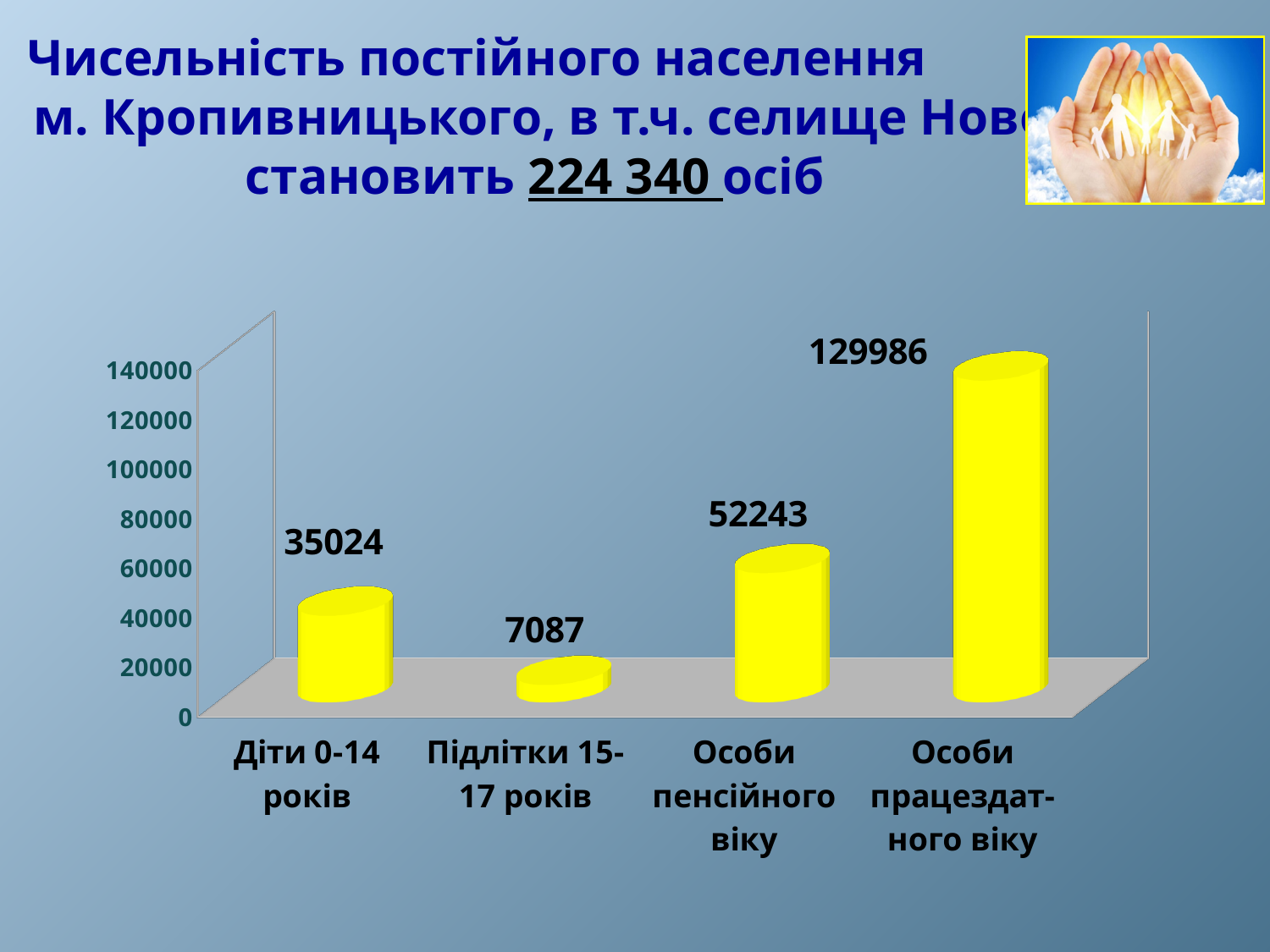
Which category has the highest value? Особи працездатного віку What is the value for Особи пенсійного віку? 52243 What kind of chart is shown on the slide? bar chart What is the value for Підлітки 15-17 років? 7087 Which is larger, the value for Особи пенсійного віку or the value for Діти 0-14 років? Особи пенсійного віку What is the difference between the values for Діти 0-14 років and Підлітки 15-17 років? 27937 What colour are the bars in the chart? yellow What is the difference between the values for Особи працездатного віку and Особи пенсійного віку? 77743 Which category has the lowest value? Підлітки 15-17 років How many categories are shown in the chart? 4 What is the value for Діти 0-14 років? 35024 What is the value for Особи працездатного віку? 129986